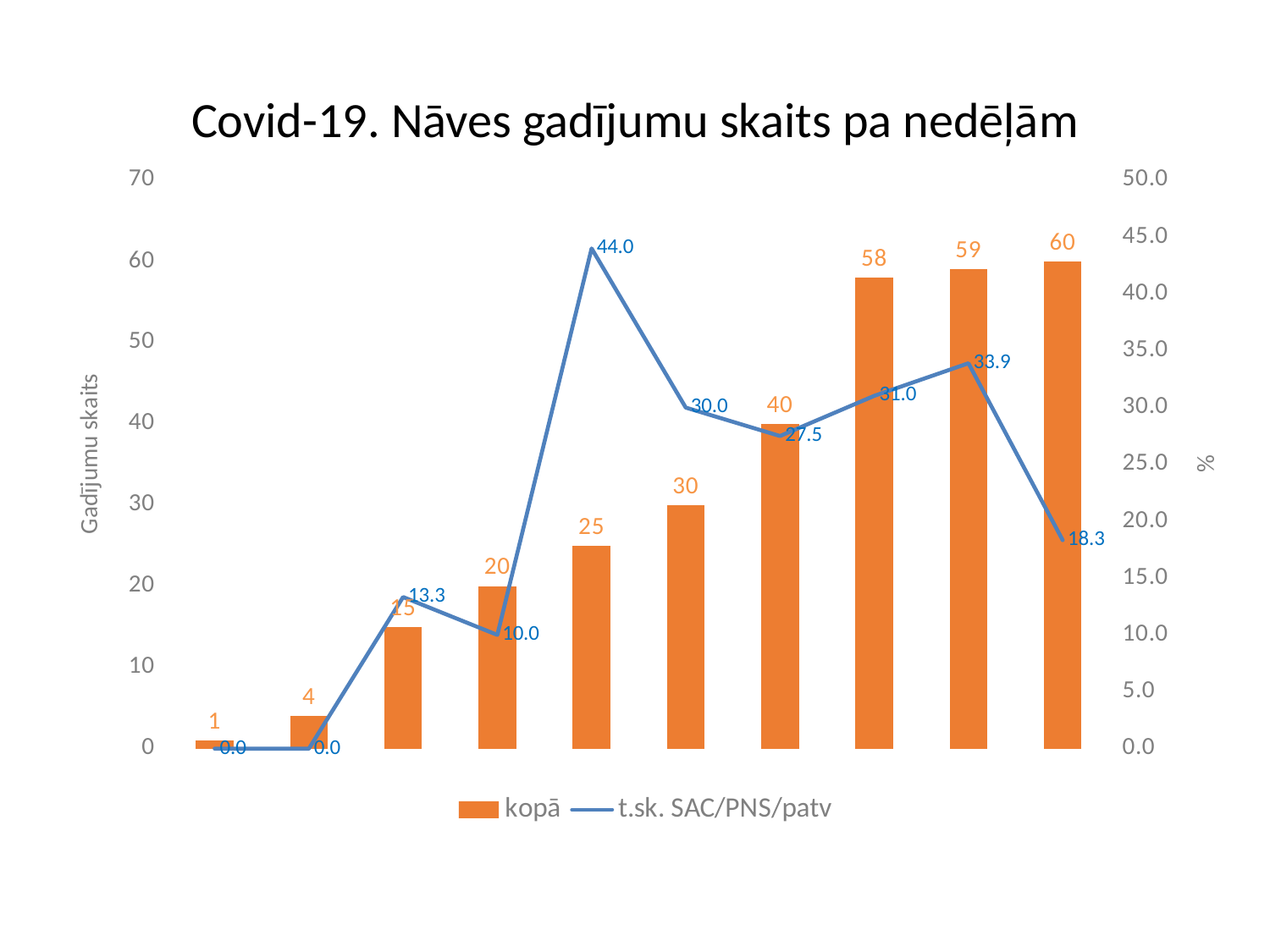
Which 'kopā' bar has the lowest value, and what is it? The first bar, 1 What is the value of the last (rightmost) 'kopā' bar? 60 What is the highest value shown on the 't.sk. SAC/PNS/patv' line? 44.0 Do the 'kopā' bar values rise or fall from left to right across the chart? Rise What is the title of the chart? Covid-19. Nāves gadījumu skaits pa nedēļām What is the difference between the last 'kopā' bar (60) and the seventh 'kopā' bar (40)? 20 What is the value of the 't.sk. SAC/PNS/patv' line at the last (rightmost) point? 18.3 How many series does the legend list? 2 What is the value of the first (leftmost) 'kopā' bar? 1 How many bars are plotted for the 'kopā' series? 10 Which is larger: the 't.sk. SAC/PNS/patv' value at the fifth point (44.0) or at the sixth point (30.0)? 44.0 at the fifth point What colour are the 'kopā' bars? Orange